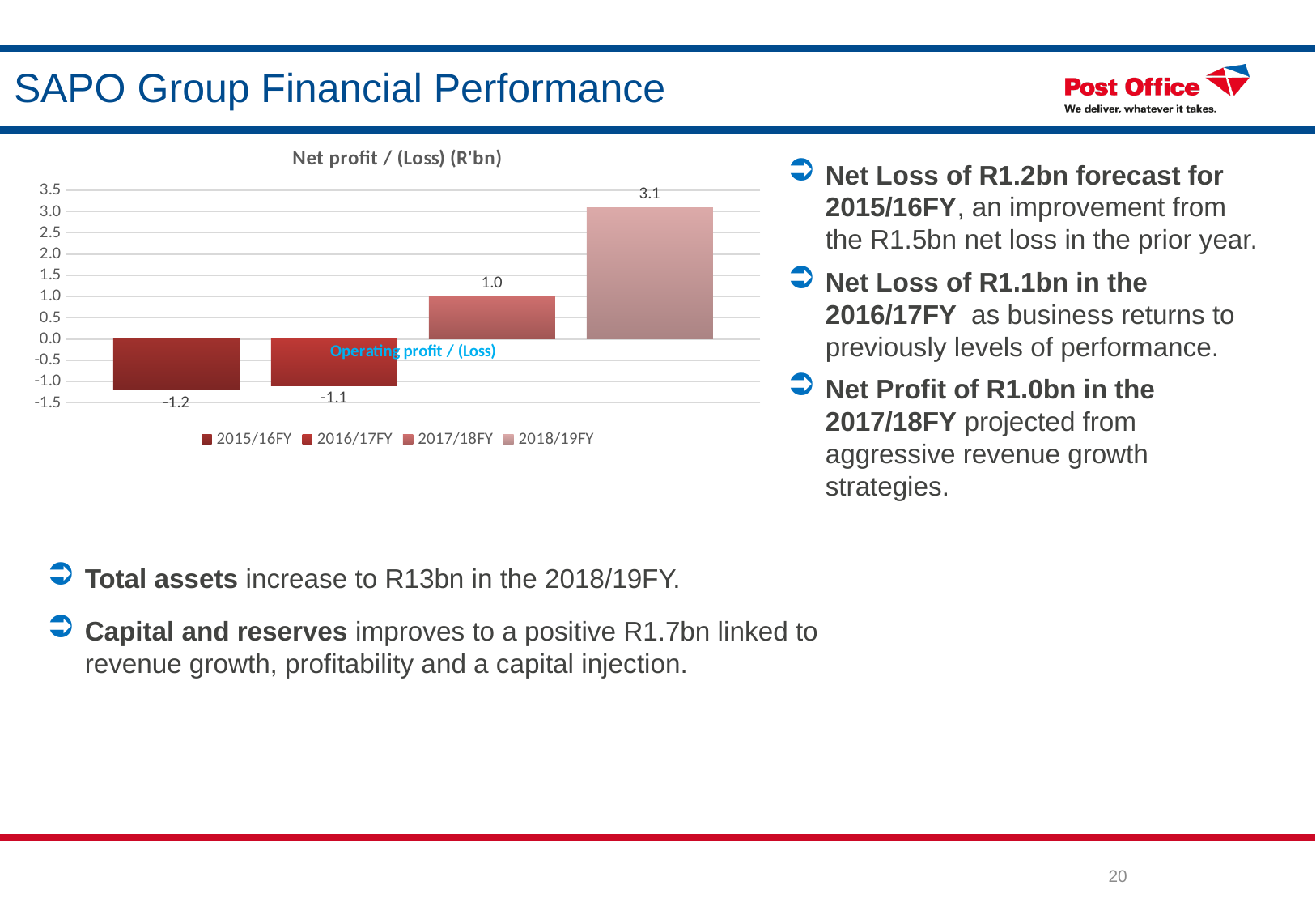
What kind of chart is shown on the slide? Bar chart How many financial years are plotted in the chart? 4 What is the net profit / (loss) value for 2016/17FY? -1.1 Which is larger, the net profit / (loss) value for 2017/18FY or for 2018/19FY? 2018/19FY Which financial year has the lowest net profit / (loss) value? 2015/16FY Do the net profit / (loss) values rise or fall from 2015/16FY to 2018/19FY? Rise What is the net profit / (loss) value for 2015/16FY? -1.2 What is the difference between the net profit / (loss) values for 2018/19FY and 2017/18FY? 2.1 What is the net profit / (loss) value for 2017/18FY? 1.0 What is the net profit / (loss) value for 2018/19FY? 3.1 How many entries does the chart legend list? 4 Which financial year has the highest net profit / (loss) value? 2018/19FY